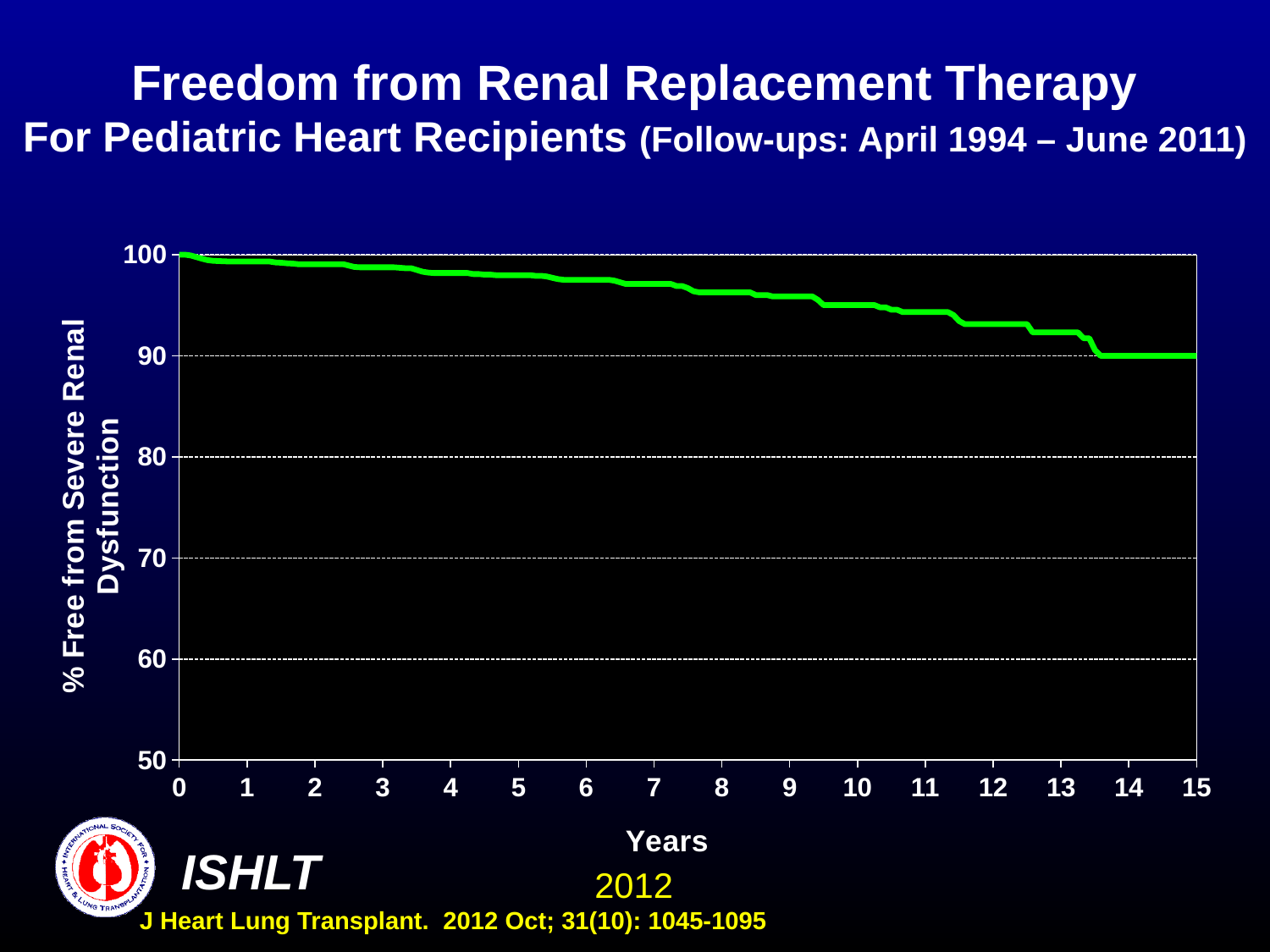
What is the highest year shown on the x axis? 15 Is the value of the line at year 10 greater or less than 90? greater What is the label of the x axis? Years Is the value of the line at year 8 greater or less than 80? greater What is the value of the line at year 0? 100 Is the value of the line at year 5 greater or less than 90? greater What is the lowest value shown on the y axis? 50 What kind of chart is shown on the slide? Line chart Does the plotted line rise or fall as the years increase along the x axis? Fall Which is larger, the value of the line at year 2 or at year 12? Year 2